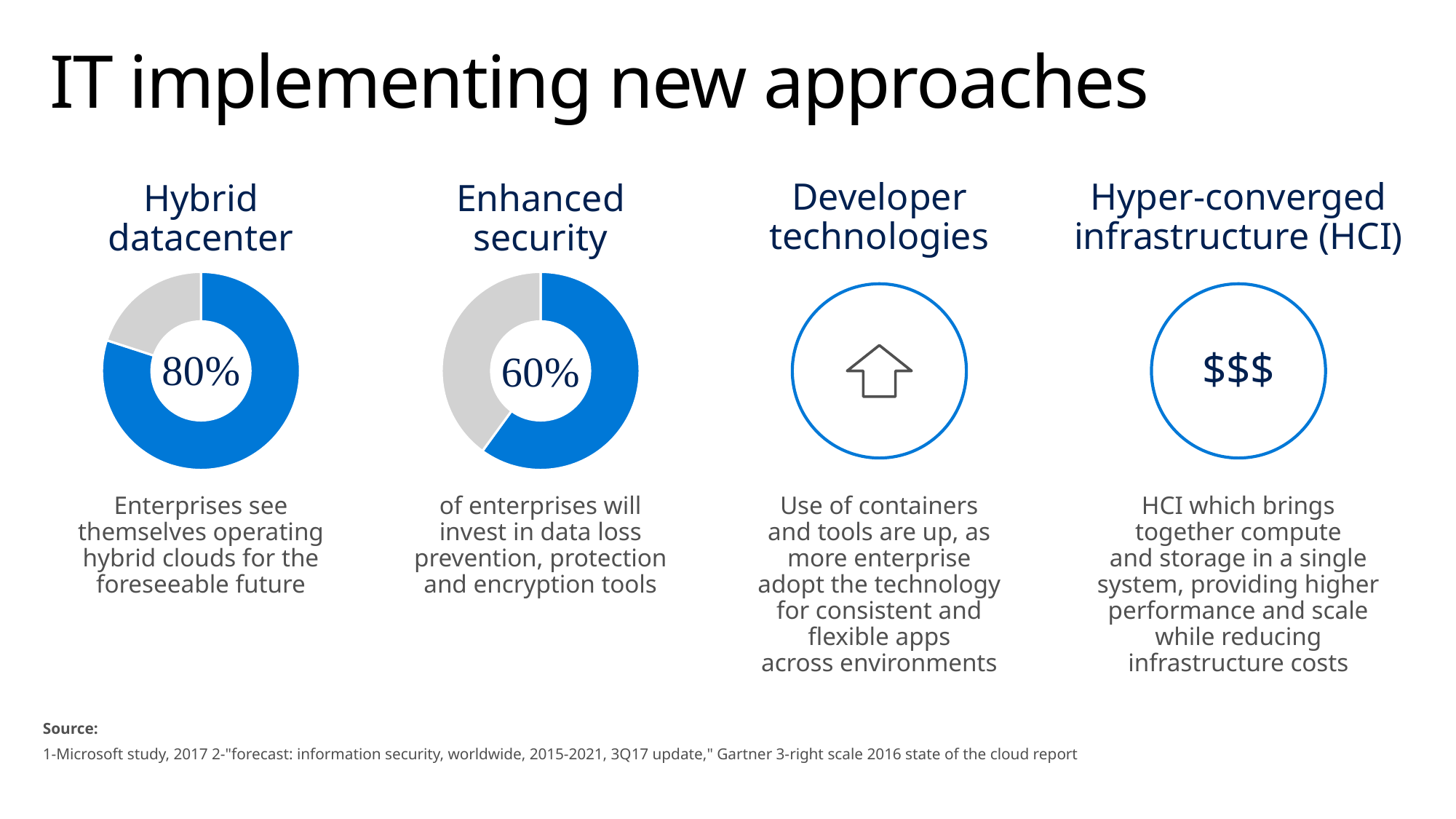
What percentage is shown in the centre of the Enhanced security donut chart? 60% How many donut charts are on the slide? 2 In the Enhanced security donut chart, what share of the ring is filled in blue? 60% What kind of chart is used under the Enhanced security heading? Donut chart In the Enhanced security donut chart, is the blue portion greater or less than 50%? greater What colour is the filled portion of the Hybrid datacenter donut chart? Blue What percentage is shown in the centre of the Hybrid datacenter donut chart? 80% What is the difference between the percentage in the Hybrid datacenter chart and the percentage in the Enhanced security chart? 20% What colour is the unfilled portion of the Enhanced security donut chart? Grey What kind of chart is used under the Hybrid datacenter heading? Donut chart In the Hybrid datacenter donut chart, what share of the ring is filled in blue? 80% Which donut chart shows the larger percentage, Hybrid datacenter or Enhanced security? Hybrid datacenter